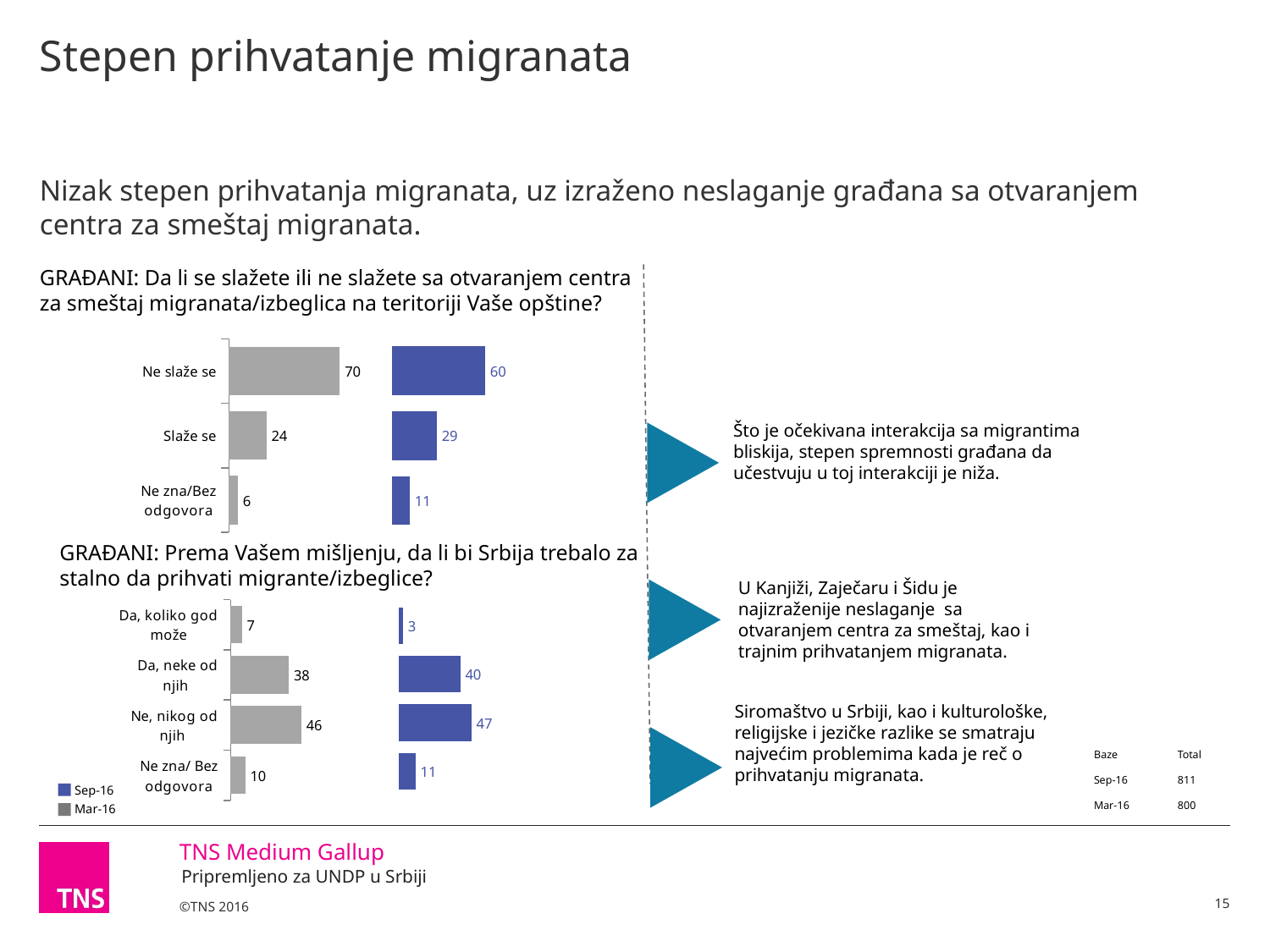
In the top chart (about opening a migrant centre), what is the Mar-16 value for 'Ne slaže se'? 70 In the top chart (about opening a migrant centre), what is the difference between the Mar-16 and Sep-16 values for 'Ne slaže se'? 10 In the bottom chart (about Serbia permanently accepting migrants), what is the difference between the Mar-16 and Sep-16 values for 'Da, koliko god može'? 4 In the top chart (about opening a migrant centre), which is larger for 'Ne zna/Bez odgovora': the Mar-16 value or the Sep-16 value? Sep-16 What type of chart is the top chart (about opening a migrant centre)? Bar chart How many series does the legend list for the charts on the slide? 2 In the top chart (about opening a migrant centre), which category has the highest Sep-16 value? Ne slaže se In the bottom chart (about Serbia permanently accepting migrants), what is the Sep-16 value for 'Ne, nikog od njih'? 47 In the bottom chart (about Serbia permanently accepting migrants), which category has the lowest Sep-16 value? Da, koliko god može How many categories does the bottom chart (about Serbia permanently accepting migrants) show? 4 In the top chart (about opening a migrant centre), what is the Sep-16 value for 'Slaže se'? 29 In the bottom chart (about Serbia permanently accepting migrants), what is the Mar-16 value for 'Da, neke od njih'? 38